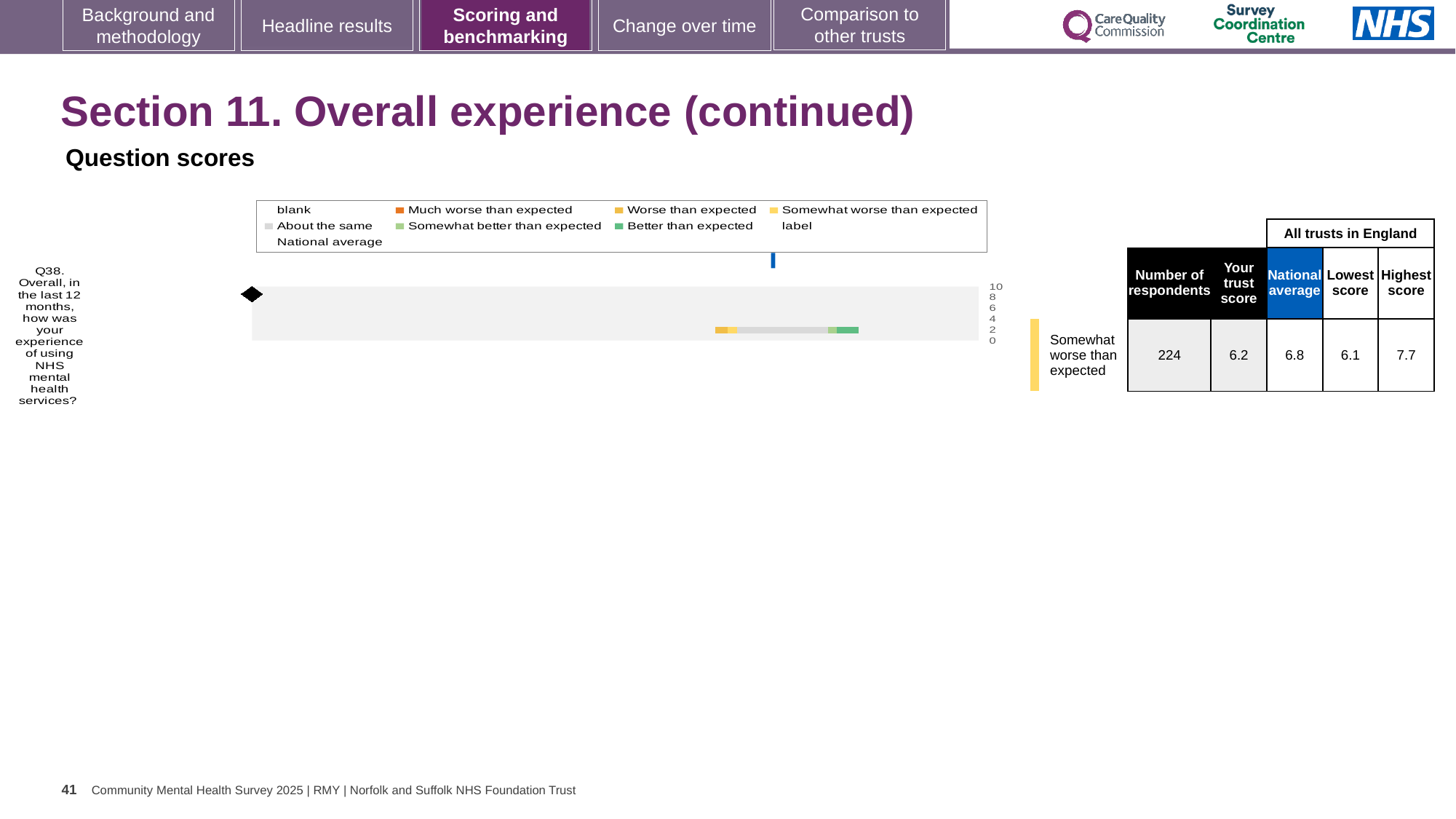
Which is larger for Q38, the trust score or the national average? national average How many respondents answered Q38? 224 What kind of chart is shown on the slide? bar chart What is the national average score for Q38 shown next to the chart? 6.8 What is the difference between the national average and the trust score for Q38? 0.6 What is the lowest score among all trusts in England for Q38? 6.1 Which benchmark category is the trust's Q38 score placed in? Somewhat worse than expected What is the trust's score for Q38 shown next to the chart? 6.2 Which question number is plotted on the chart? Q38 What is the highest tick value shown on the chart's score axis? 10 What is the highest score among all trusts in England for Q38? 7.7 How many survey questions are plotted on the chart? 1